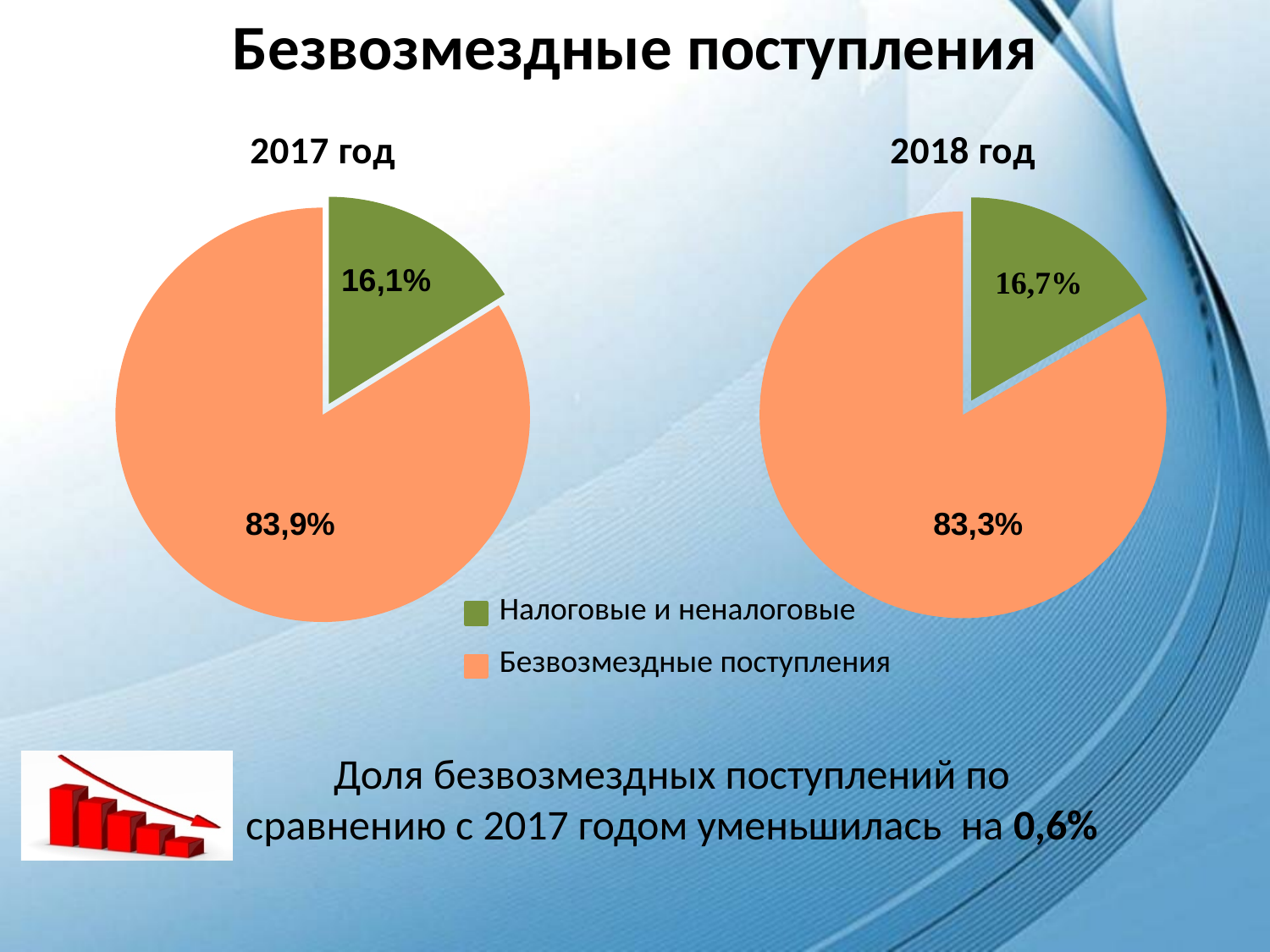
What kind of chart is the 2017 год chart? pie chart How many slices does the 2018 год pie chart have? 2 In the 2017 год chart, which category has the smallest slice? Налоговые и неналоговые In the 2018 год chart, which category has the largest slice? Безвозмездные поступления In the 2018 год chart, what share does Налоговые и неналоговые have? 16,7% What is the difference between the Безвозмездные поступления share in the 2017 год chart and in the 2018 год chart? 0,6% In the 2018 год chart, what share does Безвозмездные поступления have? 83,3% How many entries does the legend list? 2 In the 2017 год chart, what share does Безвозмездные поступления have? 83,9% Which is larger: the Налоговые и неналоговые share in the 2017 год chart or in the 2018 год chart? 2018 год What colour represents Безвозмездные поступления in the charts? orange